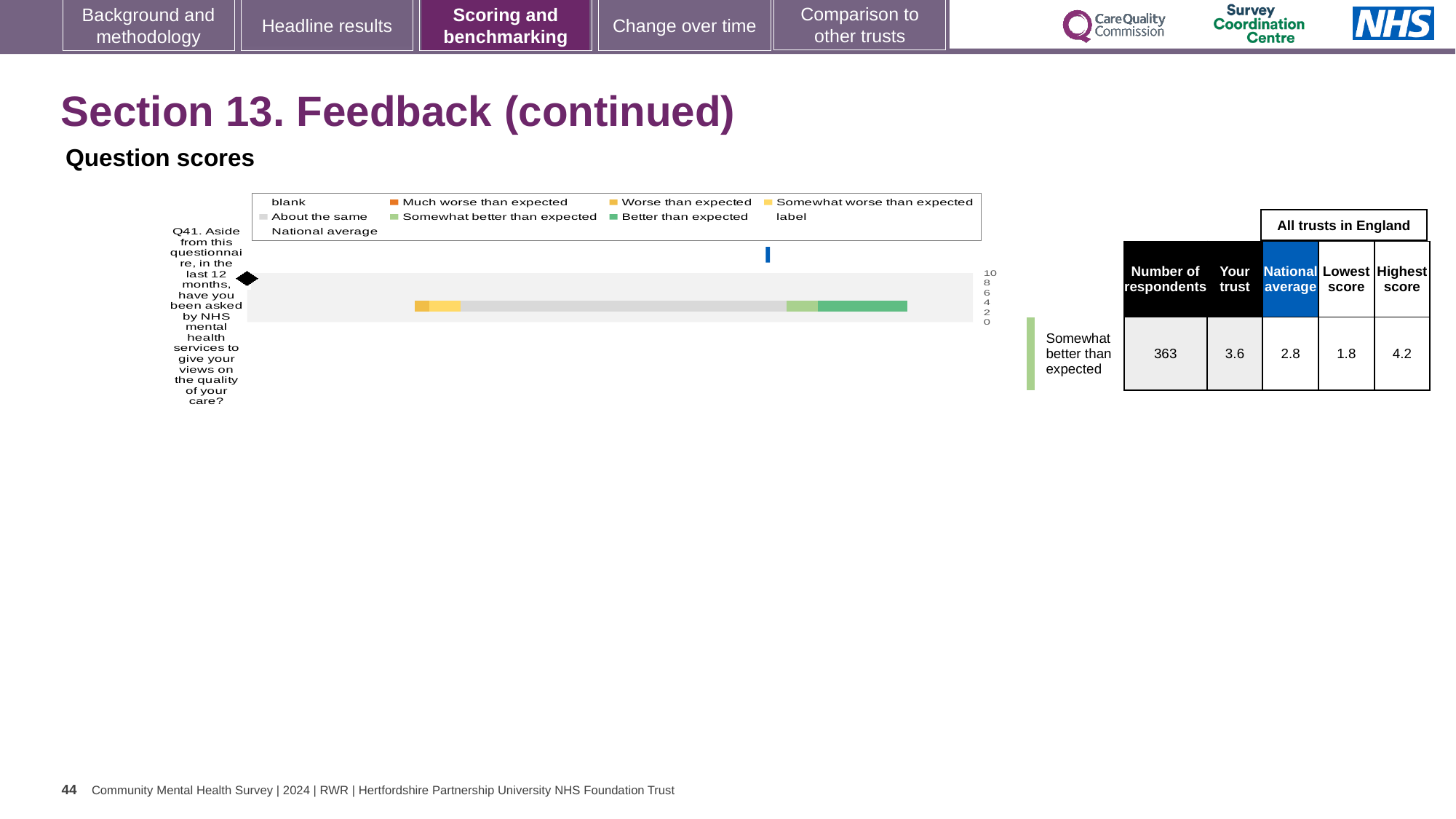
What is the 'Your trust' score for Q41? 3.6 What is the highest score among all trusts in England for Q41? 4.2 What is the highest tick value shown on the chart's score axis? 10 What is the national average score for Q41? 2.8 How many respondents answered Q41? 363 Which question number is plotted in the chart? Q41 What kind of chart is used to show the Q41 question score? bar chart What is the difference between the highest score and the lowest score for Q41? 2.4 What is the lowest score among all trusts in England for Q41? 1.8 What is the difference between the 'Your trust' score and the national average for Q41? 0.8 How many questions are plotted in the chart? 1 Which is larger for Q41, the 'Your trust' score or the national average? Your trust